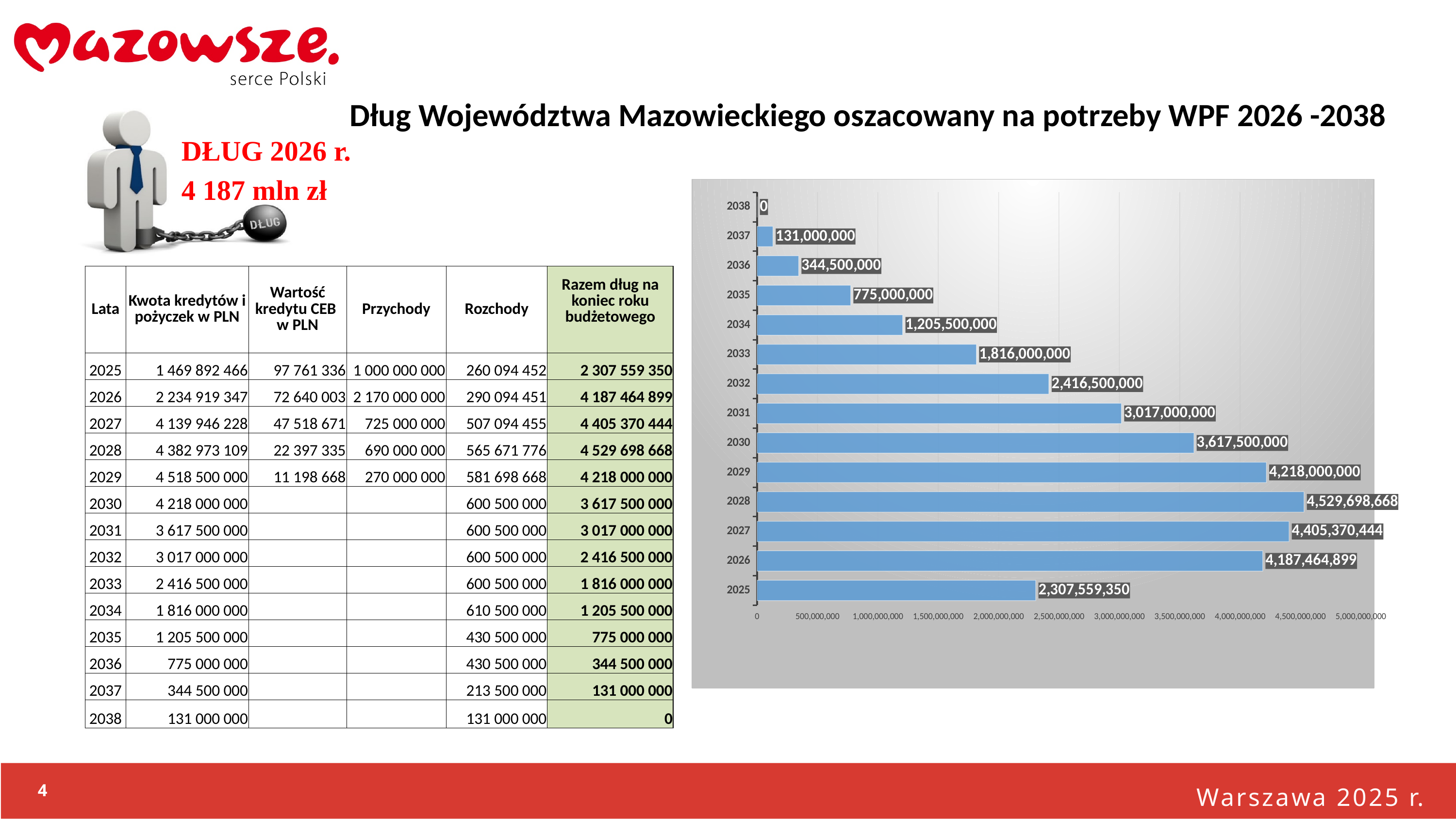
Is the value for 2034 in the chart greater or less than 1,500,000,000? less Which year has the highest value in the chart? 2028 What is the value shown for 2033 in the chart? 1,816,000,000 Which year has the larger value in the chart, 2029 or 2026? 2029 What is the difference between the values for 2030 and 2031 in the chart? 600,500,000 How many years (bars) are plotted in the chart? 14 Which year has the lowest value in the chart? 2038 What is the value shown for 2037 in the chart? 131,000,000 What kind of chart is shown on the right side of the slide? bar chart Do the values in the chart rise or fall from 2028 to 2038? fall What is the difference between the values for 2028 and 2027 in the chart? 124,328,224 What is the value shown for 2026 in the chart? 4,187,464,899